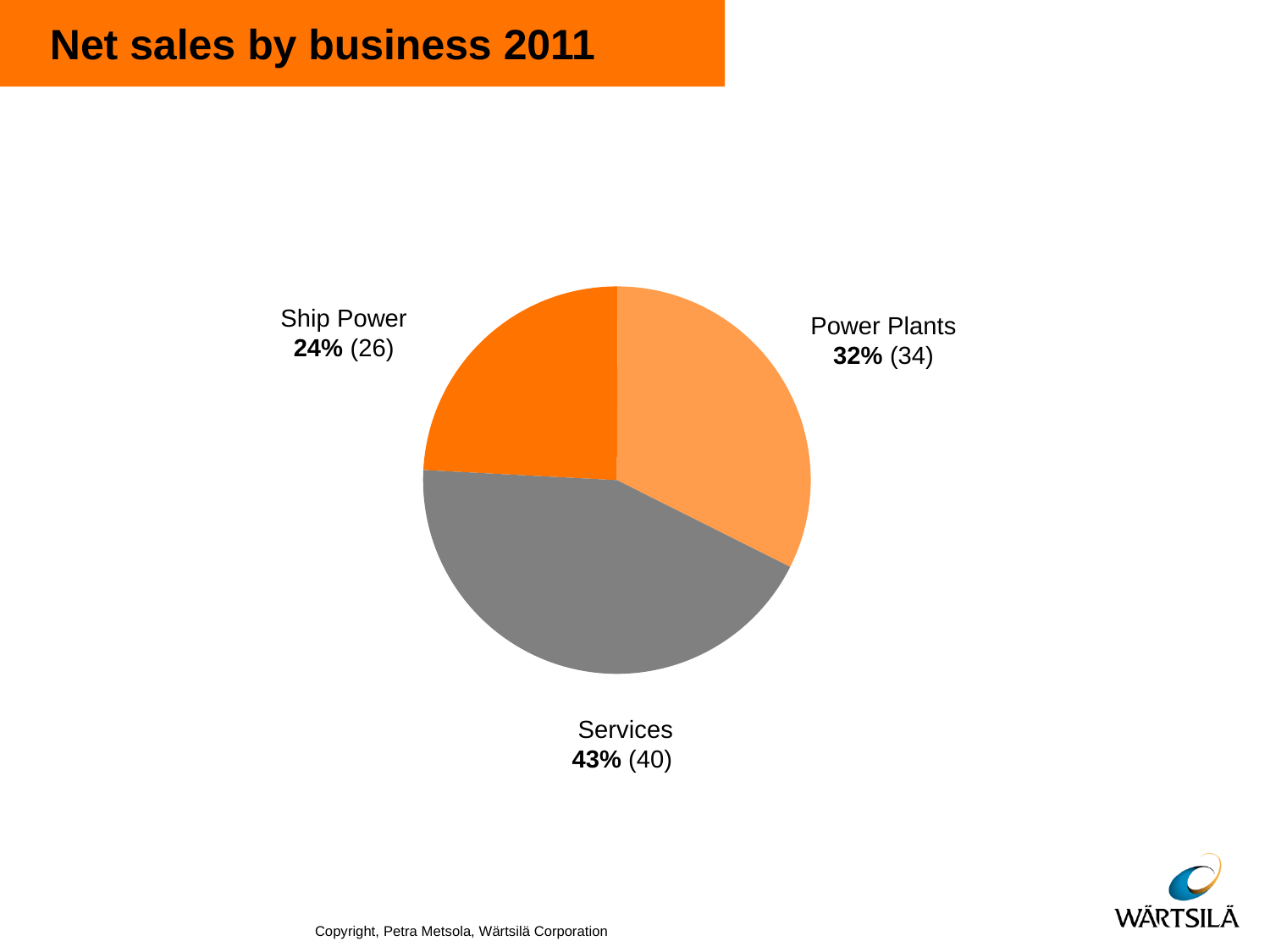
Which business has the smallest share of net sales? Ship Power What is the value shown in parentheses for Ship Power? 26 Which has a larger share of net sales, Power Plants or Ship Power? Power Plants What share of net sales does Services account for? 43% What share of net sales does Ship Power account for? 24% What is the title of the chart? Net sales by business 2011 Which business has the largest share of net sales? Services What share of net sales does Power Plants account for? 32% What colour is the Services slice? Grey What is the difference in percentage points between the Services share and the Power Plants share? 11 How many businesses are shown in the pie chart? 3 What kind of chart is shown on the slide? Pie chart